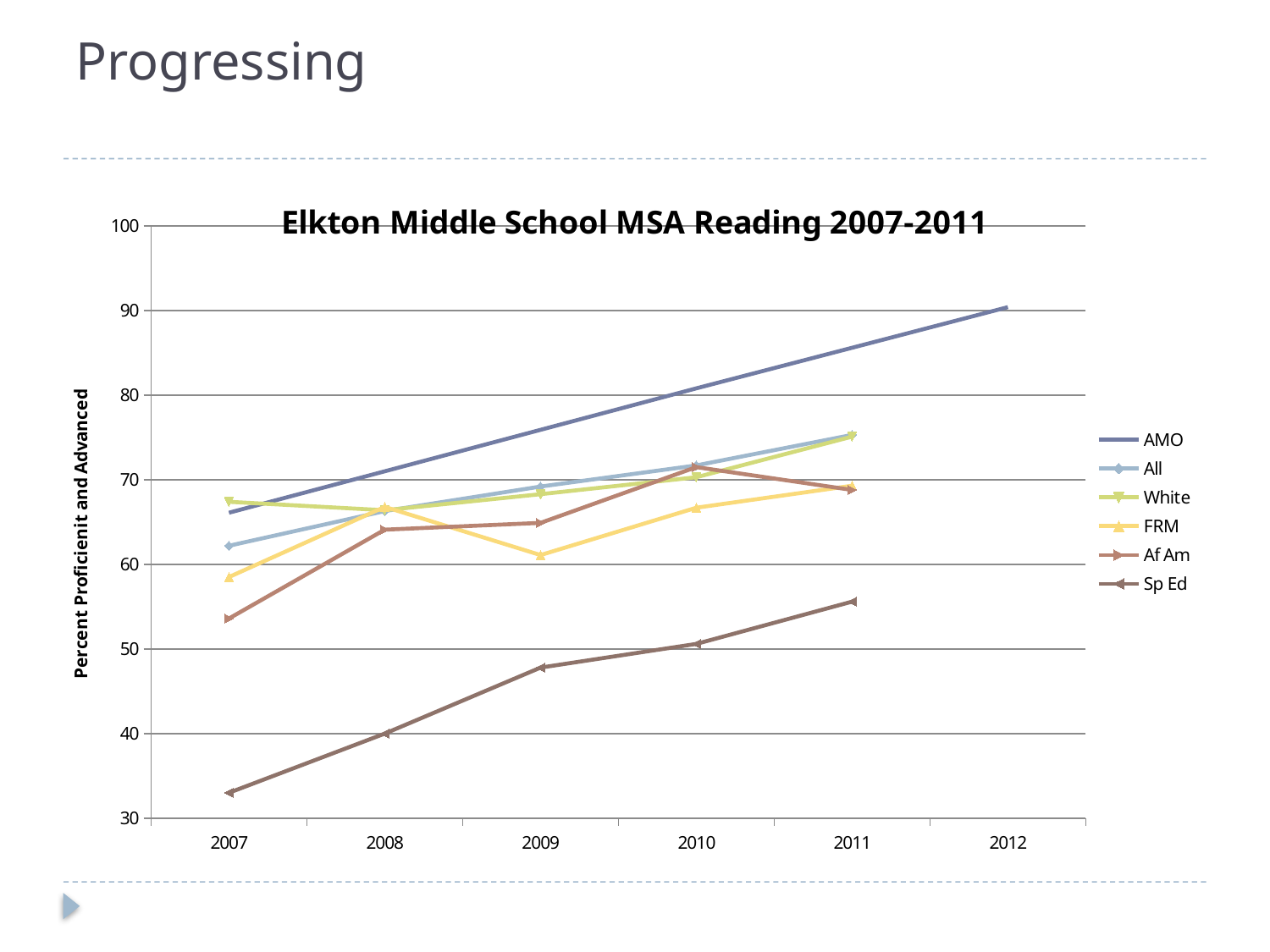
Does the Sp Ed line rise or fall from 2007 to 2011? Rises Is the value for Af Am in 2007 greater or less than 60? less What is the title of the chart? Elkton Middle School MSA Reading 2007-2011 Which series has the highest value in 2010? AMO What kind of chart is shown on the slide? Line chart Is the value for Sp Ed in 2007 greater or less than 40? less How many years are marked on the x axis? 6 What is the label of the vertical axis? Percent Proficienit and Advanced Is the value for AMO in 2012 greater or less than 80? greater Which is larger in 2009, the value for White or the value for FRM? White Which series has the lowest value in 2009? Sp Ed How many series does the legend list? 6